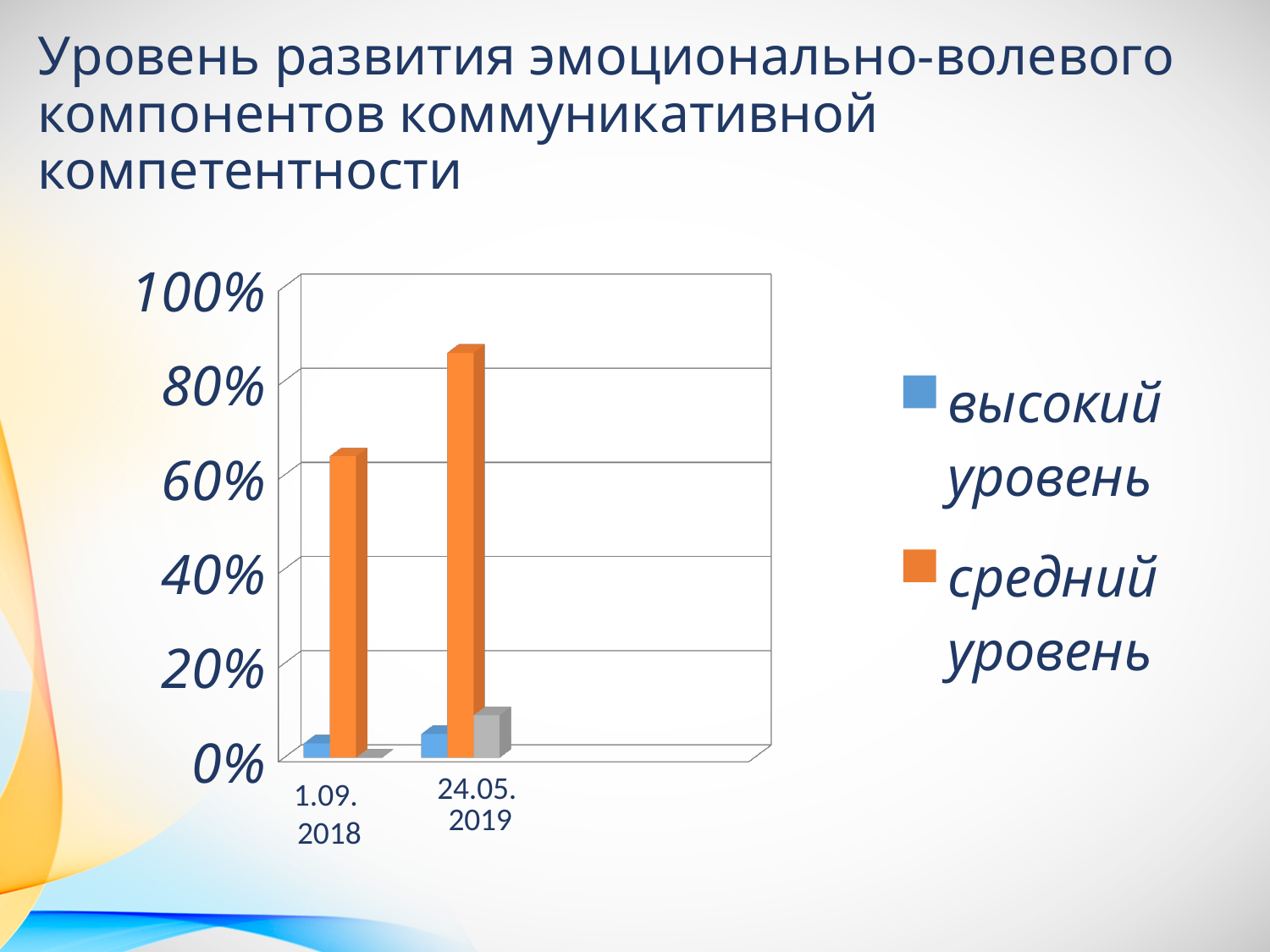
Is the value for высокий уровень on 1.09.2018 greater or less than 20%? less What is the highest value shown on the chart's vertical axis? 100% On 1.09.2018, which series has the larger value, высокий уровень or средний уровень? средний уровень How many series does the chart legend list? 2 Is the value for средний уровень on 1.09.2018 greater or less than 40%? greater Does the value for средний уровень rise or fall from 1.09.2018 to 24.05.2019? rise What kind of chart is shown on the slide? bar chart Which date has the higher value for средний уровень, 1.09.2018 or 24.05.2019? 24.05.2019 Is the value for средний уровень on 24.05.2019 greater or less than 80%? greater Which colour represents средний уровень in the chart legend? orange How many categories (dates) are shown on the x axis of the chart? 2